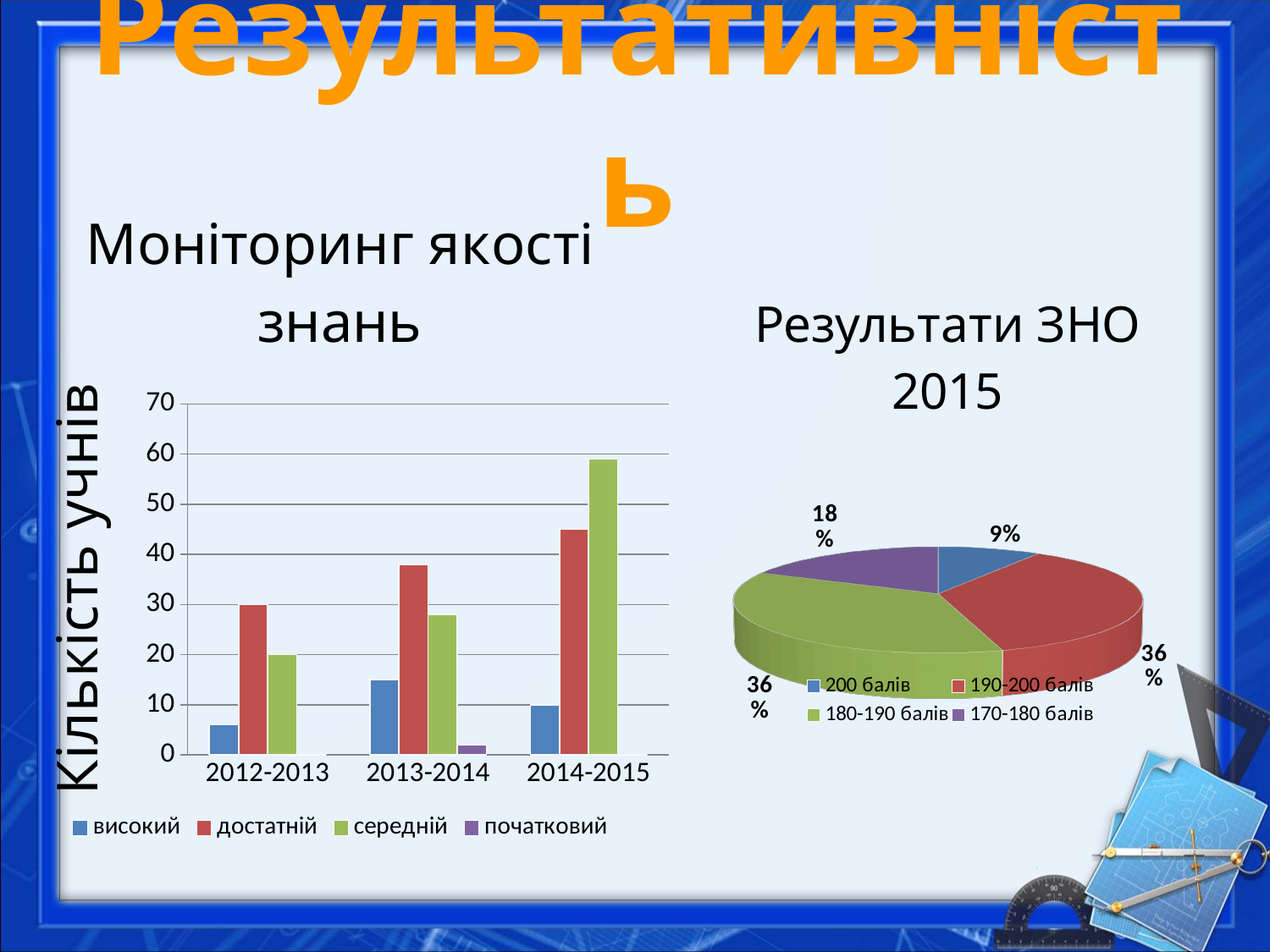
What kind of chart is the 'Моніторинг якості знань' chart? bar chart What kind of chart is the 'Результати ЗНО 2015' chart? pie chart In the 'Моніторинг якості знань' chart, which is larger in 2013-2014: 'достатній' or 'середній'? достатній In the 'Моніторинг якості знань' chart, which series has the highest bar in 2014-2015? середній In the 'Результати ЗНО 2015' chart, what share is labelled for '200 балів'? 9% How many school-year categories are shown on the x axis of the 'Моніторинг якості знань' chart? 3 In the 'Результати ЗНО 2015' chart, what share is labelled for '170-180 балів'? 18% How many series does the legend of the 'Моніторинг якості знань' chart list? 4 In the 'Моніторинг якості знань' chart, does the value for 'достатній' rise or fall from 2012-2013 to 2014-2015? rise In the 'Результати ЗНО 2015' chart, which category has the smallest slice? 200 балів In the 'Моніторинг якості знань' chart, is the value for 'високий' in 2012-2013 greater or less than 10? less In the 'Моніторинг якості знань' chart, is the value for 'середній' in 2014-2015 greater or less than 50? greater